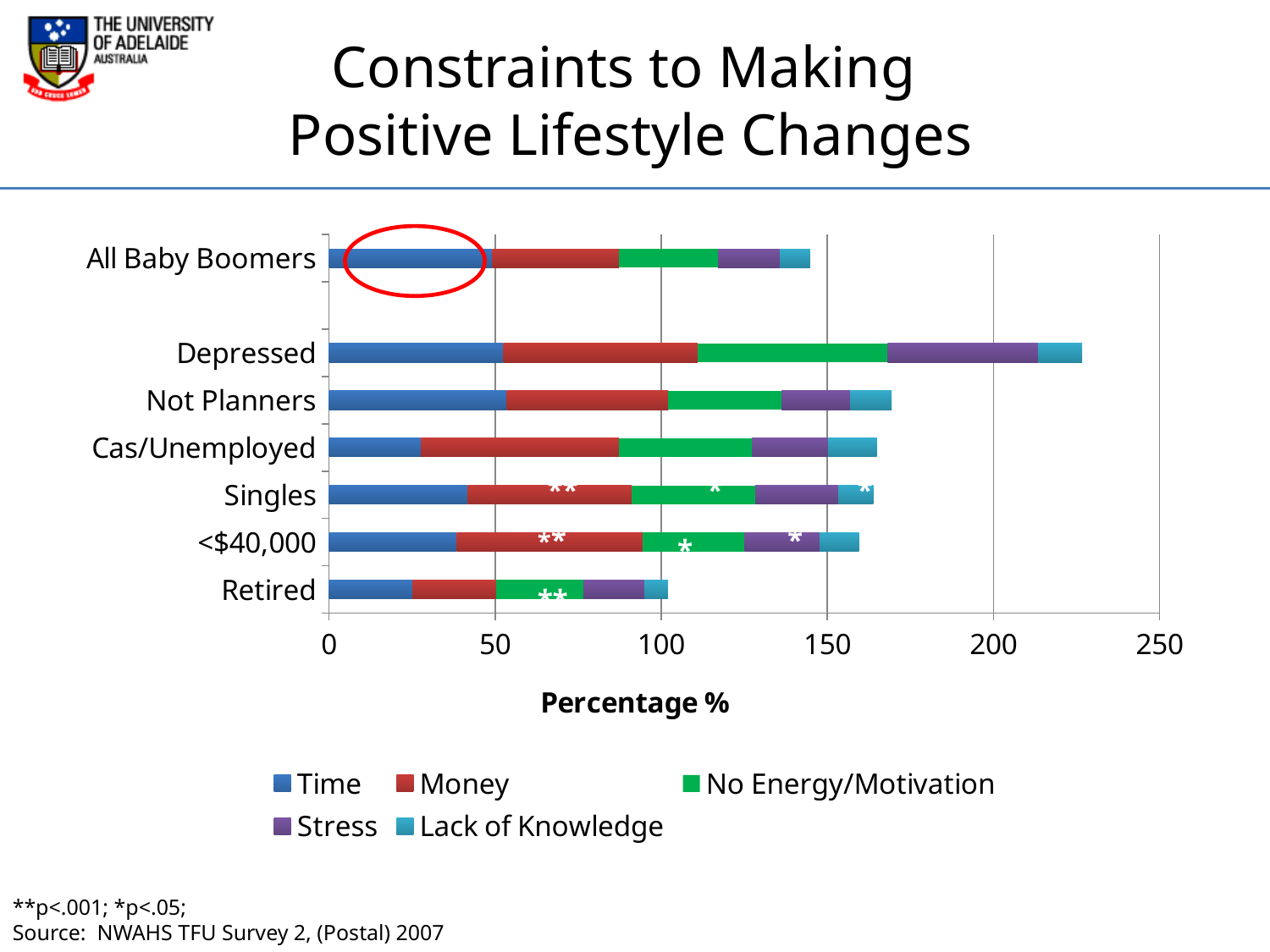
How many series does the chart's legend list? 5 Which has the longer total stacked bar, Depressed or Retired? Depressed Which series is shown in blue in the chart's legend? Time Is the total stacked bar for Depressed greater or less than 200? greater What kind of chart is shown on the slide? stacked bar chart How many categories are plotted on the vertical axis of the chart? 7 Which category has the longest total stacked bar? Depressed Is the total stacked bar for Retired greater or less than 150? less Which category has the shortest total stacked bar? Retired What is the title of the horizontal axis of the chart? Percentage % Is the total stacked bar for All Baby Boomers greater or less than 150? less